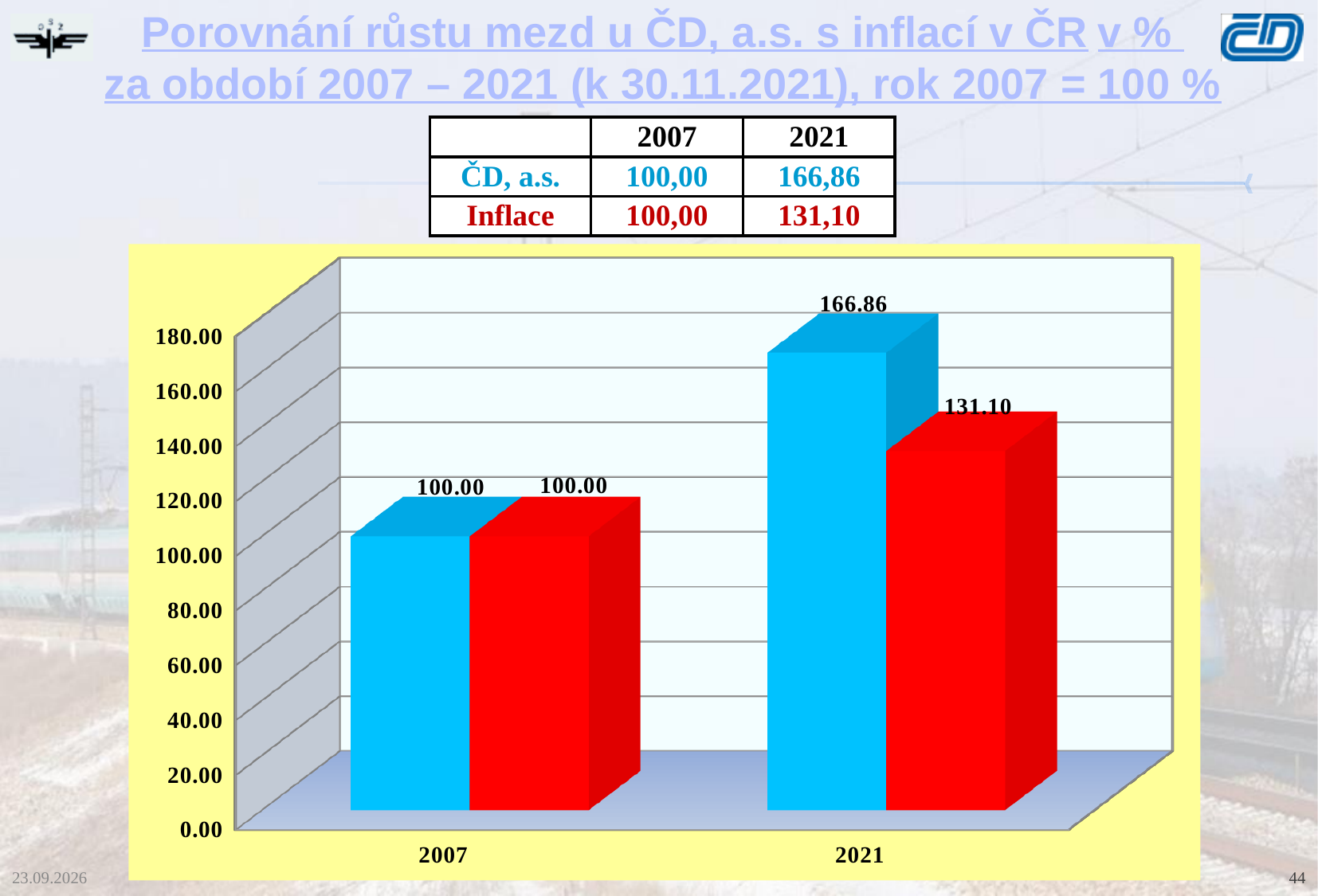
What type of chart is shown on the slide? bar chart For 2021, which is larger: the blue bar (ČD, a.s.) or the red bar (Inflace)? the blue bar (ČD, a.s.) Do the values of the blue bars rise or fall from 2007 to 2021? rise What is the value of the blue bar (ČD, a.s.) for 2021? 166.86 How many categories are shown on the x axis of the chart? 2 What is the difference between the blue bar and the red bar for 2021? 35.76 Which bar has the highest value in the chart? ČD, a.s. in 2021 (166.86) Is the value of the red bar for 2021 greater or less than 120.00? greater What is the value of the blue bar (ČD, a.s.) for 2007? 100.00 What is the highest value shown on the chart's vertical axis? 180.00 What is the value of the red bar (Inflace) for 2021? 131.10 What is the value of the red bar (Inflace) for 2007? 100.00